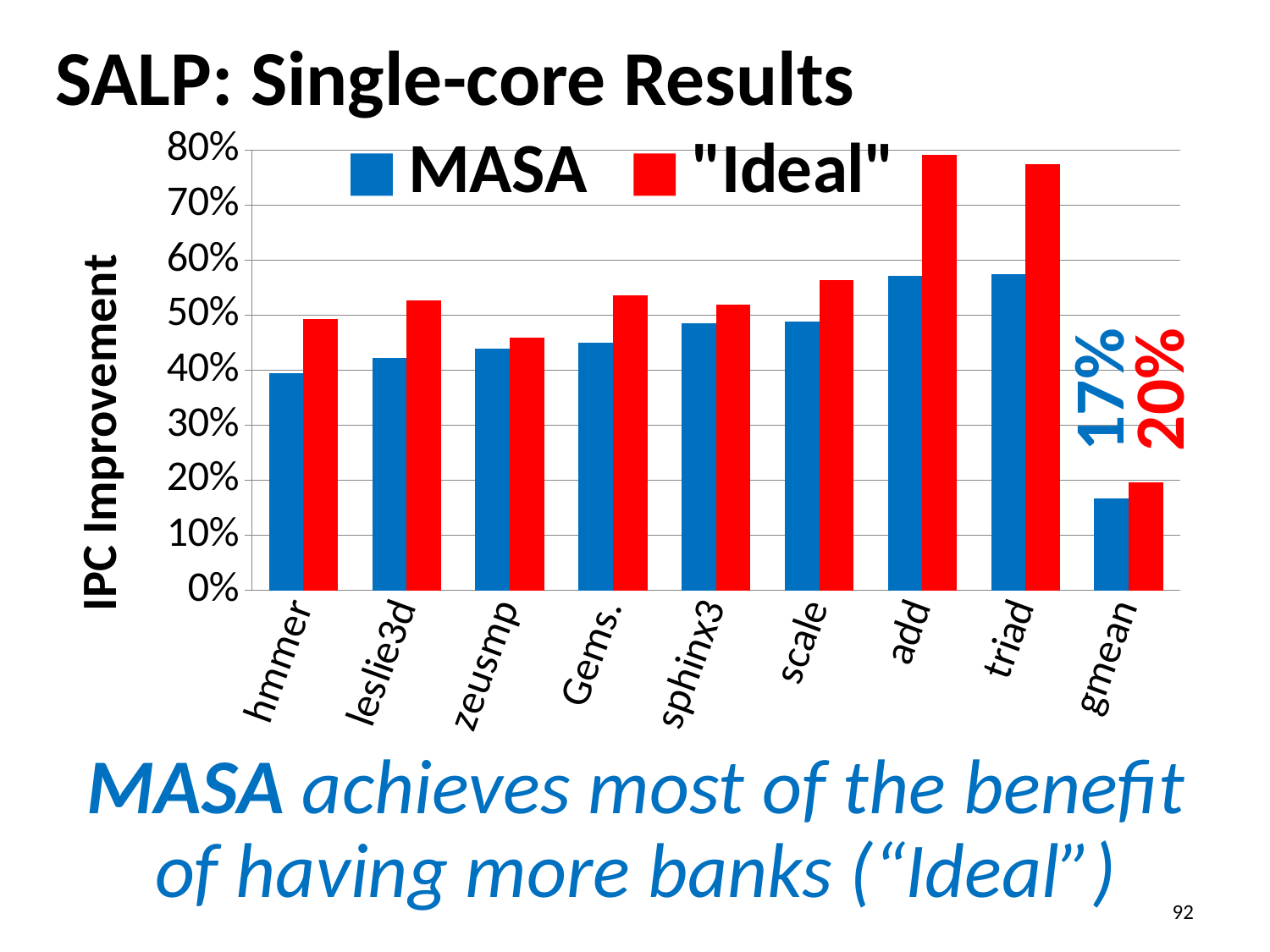
What kind of chart is shown on the slide? bar chart Is the "Ideal" value for add greater or less than 70%? greater What is the title of the y axis? IPC Improvement Which category has the lowest MASA value? gmean For hmmer, which is larger: the MASA value or the "Ideal" value? "Ideal" How many series does the legend list? 2 Which category has the highest "Ideal" value? add What is the difference between the "Ideal" and MASA values for gmean? 3% What is the MASA value for gmean? 17% Is the "Ideal" value for zeusmp greater or less than 50%? less What is the "Ideal" value for gmean? 20% How many categories are shown on the x axis? 9